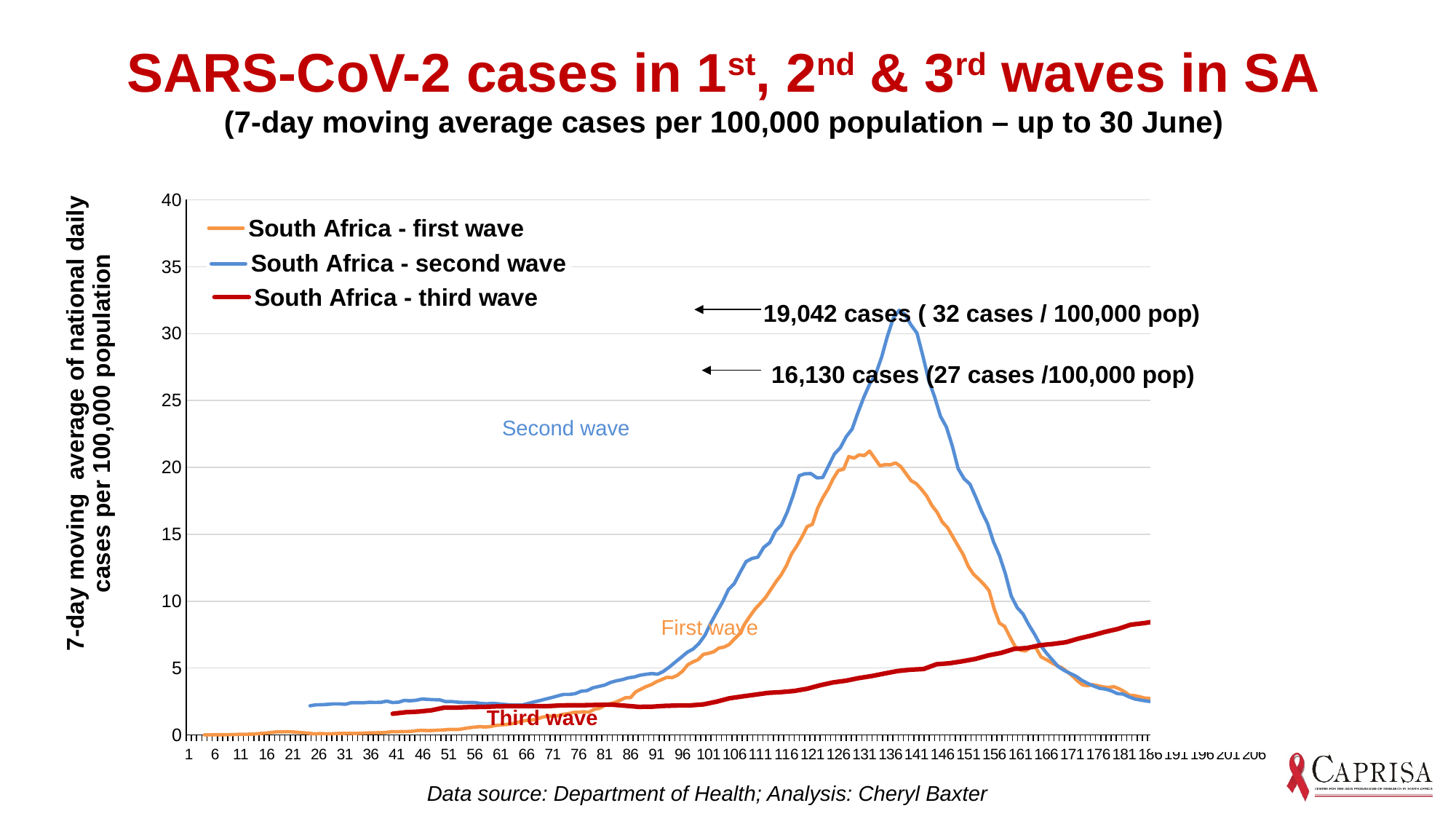
How many series does the legend list? 3 Is the peak value of the second wave greater or less than 30? greater Which wave reaches the highest peak on the chart? South Africa - second wave What type of chart is shown on the slide? line chart Is the value of the third wave at day 186 greater or less than 10? less Is the peak value of the first wave greater or less than 25? less At day 176, which is higher: the second wave or the third wave? third wave According to the annotation, what was the second wave peak in cases per 100,000 population? 32 cases / 100,000 pop At day 131, which is higher: the first wave or the second wave? second wave According to the annotation, how many cases were recorded at the second wave peak? 19,042 cases What is the highest value shown on the y axis? 40 Does the third wave line rise or fall along the x axis? rises